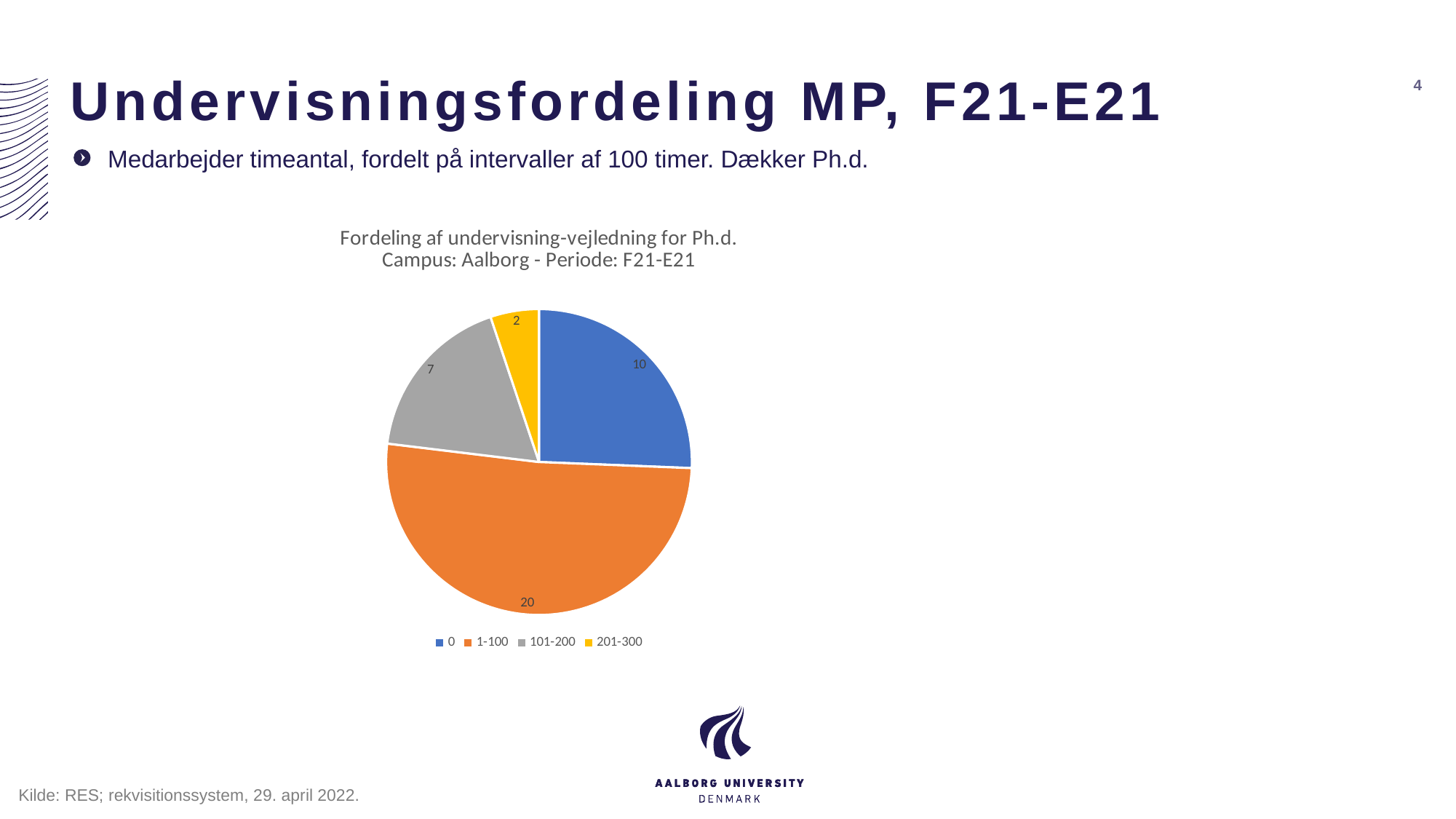
What type of chart is shown on the slide? pie chart What is the value for the 201-300 category? 2 What is the value for the 0 category? 10 What is the total of all slices in the pie chart? 39 What is the value for the 101-200 category? 7 Which category has the largest slice? 1-100 Which colour represents the 101-200 category in the legend? gray What is the difference between the values for 1-100 and 0? 10 Which is larger, the value for 101-200 or the value for 201-300? 101-200 How many categories does the pie chart have? 4 What is the value for the 1-100 category? 20 Which category has the smallest slice? 201-300